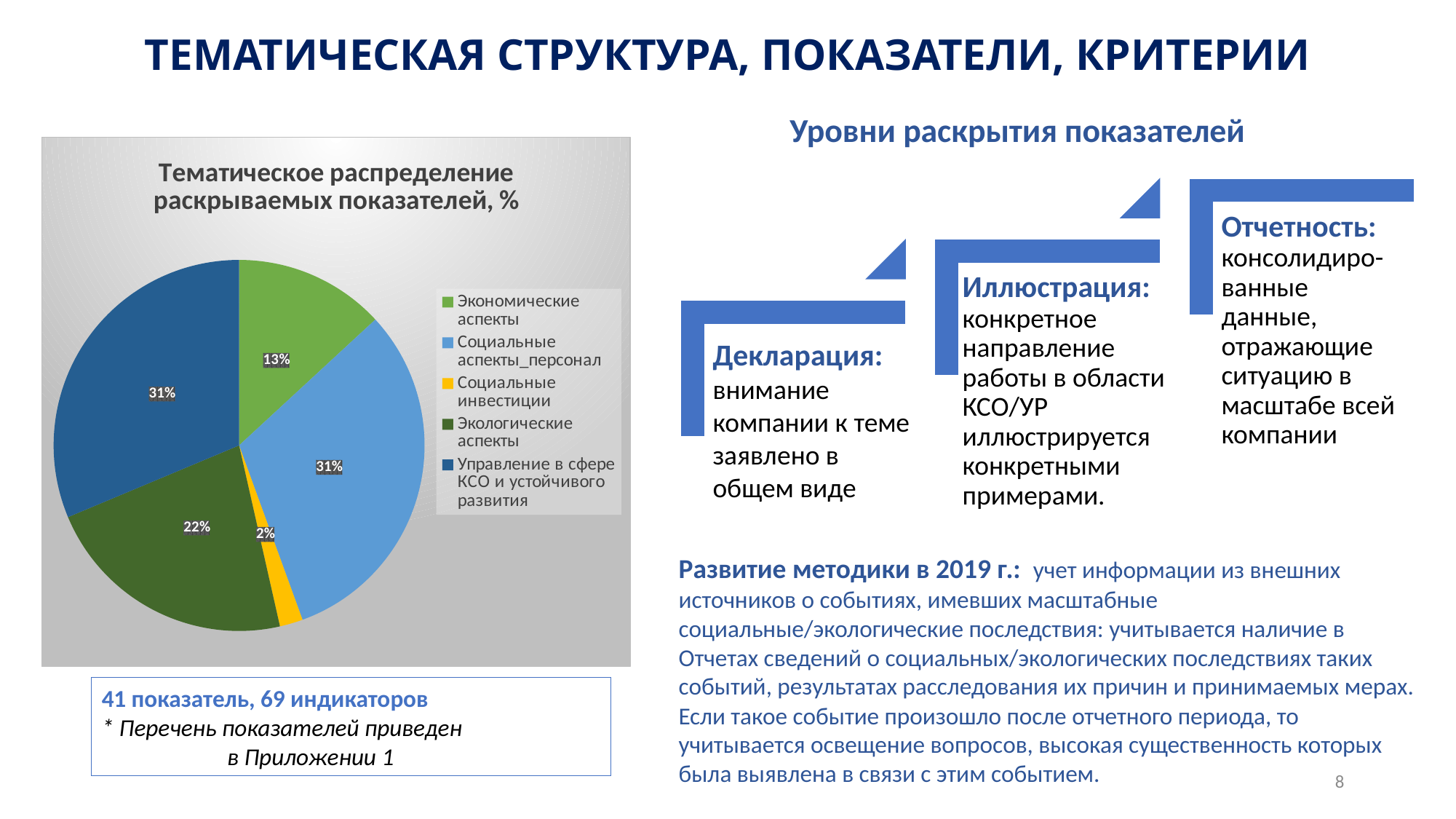
What is the title of the pie chart? Тематическое распределение раскрываемых показателей, % Which colour represents "Социальные инвестиции" in the pie chart? Yellow What is the value for "Экологические аспекты" in the pie chart? 22% What is the difference between the values for "Экологические аспекты" and "Экономические аспекты"? 9% What kind of chart is shown on the slide? Pie chart What is the value for "Социальные аспекты_персонал" in the pie chart? 31% What is the value for "Управление в сфере КСО и устойчивого развития" in the pie chart? 31% How many slices does the pie chart have? 5 What is the value for "Социальные инвестиции" in the pie chart? 2% What share of the pie is labelled "Экономические аспекты"? 13% Which is larger in the pie chart: "Экологические аспекты" or "Экономические аспекты"? Экологические аспекты Which category has the smallest slice in the pie chart? Социальные инвестиции